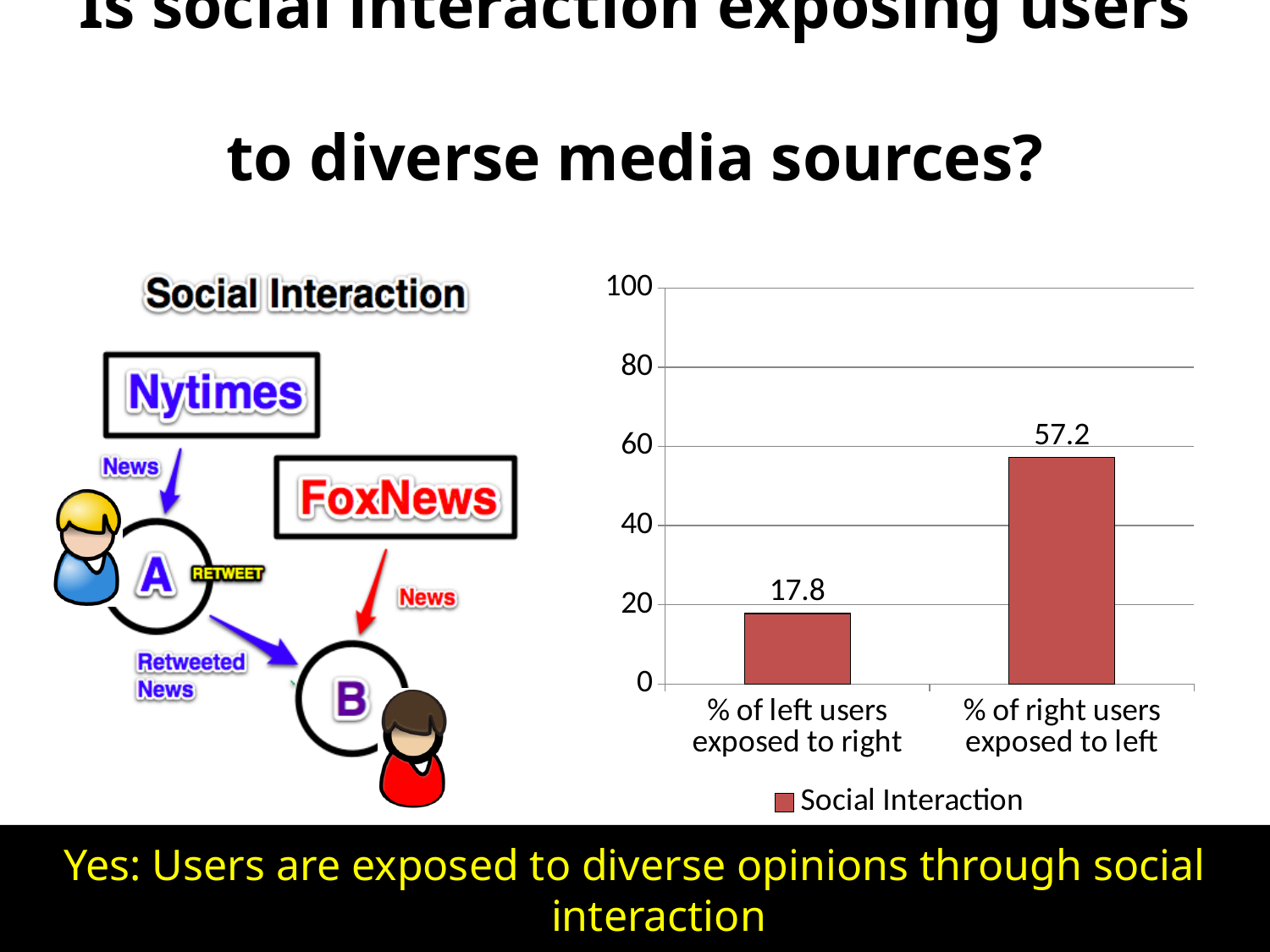
What is the value for '% of left users exposed to right'? 17.8 What is the difference between the value for '% of right users exposed to left' and '% of left users exposed to right'? 39.4 How many series does the legend list? 1 How many categories are shown on the chart? 2 What kind of chart is shown? bar chart What is the name of the series listed in the legend? Social Interaction What is the value for '% of right users exposed to left'? 57.2 Is the value for '% of left users exposed to right' greater or less than 20? less Which category has the highest value? % of right users exposed to left Is the value for '% of right users exposed to left' greater or less than 40? greater Which is larger: the value for '% of left users exposed to right' or '% of right users exposed to left'? % of right users exposed to left Which category has the lowest value? % of left users exposed to right